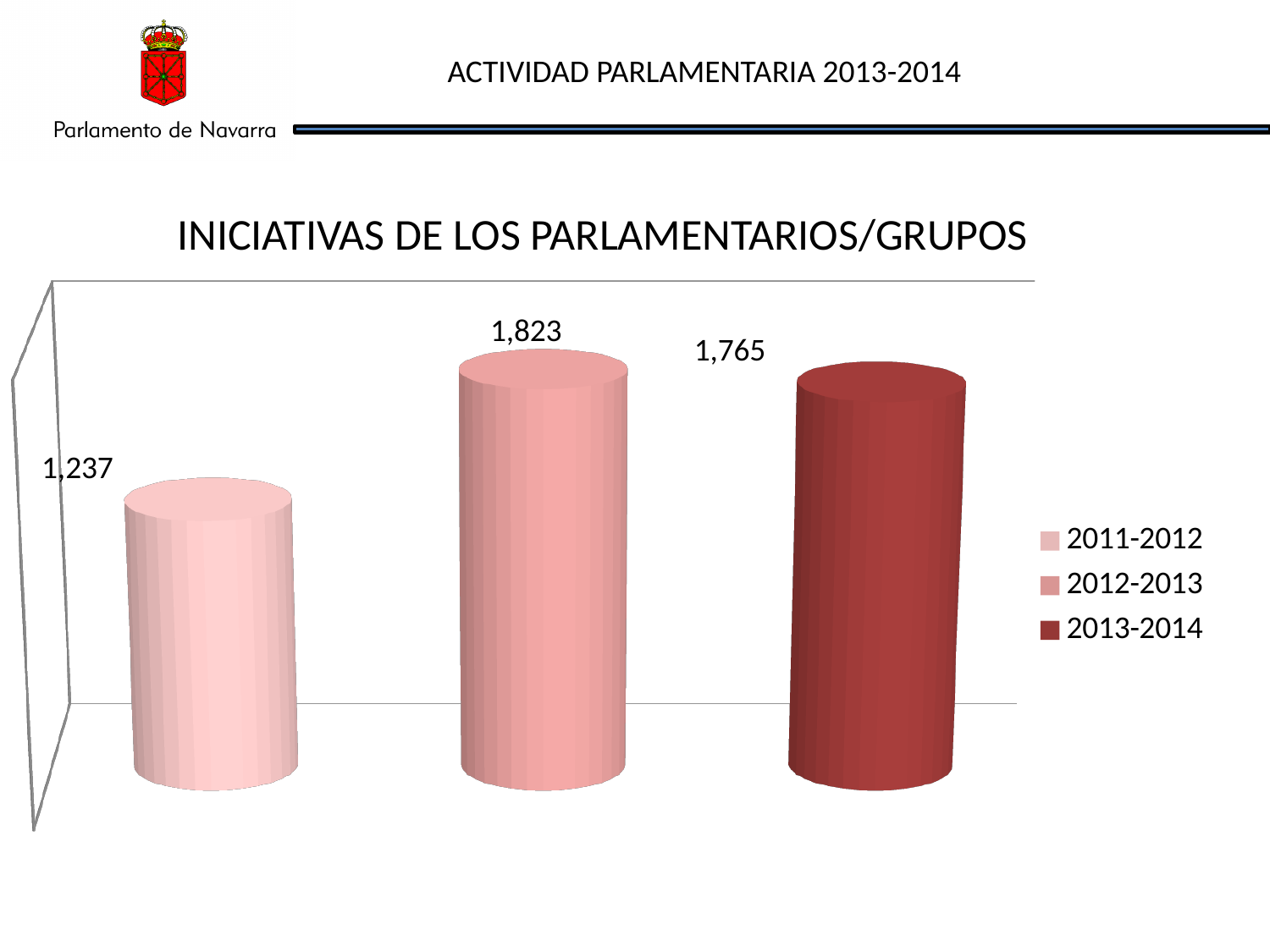
What is the difference between the values for 2012-2013 and 2013-2014? 58 What kind of chart is shown? bar chart What is the title of the chart? INICIATIVAS DE LOS PARLAMENTARIOS/GRUPOS What is the difference between the values for 2012-2013 and 2011-2012? 586 Which period has the highest value? 2012-2013 What is the value for 2012-2013? 1,823 How many entries does the legend list? 3 Which is larger, the value for 2011-2012 or the value for 2013-2014? 2013-2014 Which period has the lowest value? 2011-2012 How many bars are plotted in the chart? 3 What is the value for 2013-2014? 1,765 What is the value for 2011-2012? 1,237